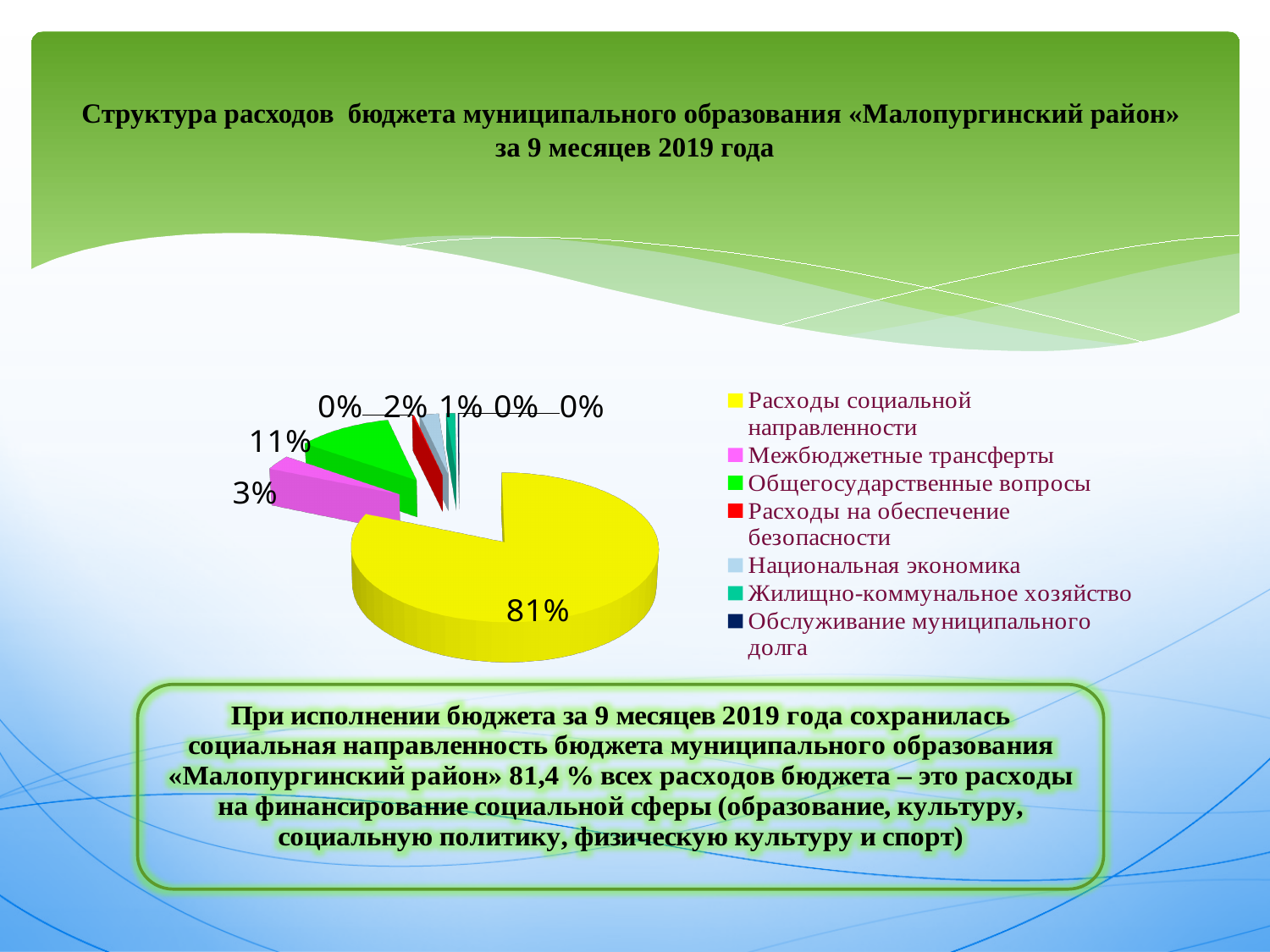
What colour is the slice for «Межбюджетные трансферты»? pink What type of chart is shown on the slide? pie chart What share of the pie does «Общегосударственные вопросы» have? 11% Which category has the largest slice of the pie? Расходы социальной направленности What share of the pie does «Межбюджетные трансферты» have? 3% What is the difference between the shares of «Общегосударственные вопросы» and «Межбюджетные трансферты»? 8% What share of the pie does «Расходы социальной направленности» have? 81% What is the difference between the shares of «Расходы социальной направленности» and «Общегосударственные вопросы»? 70% Which is larger: «Общегосударственные вопросы» or «Межбюджетные трансферты»? Общегосударственные вопросы How many entries does the chart legend list? 7 What colour is the slice for «Расходы социальной направленности»? yellow